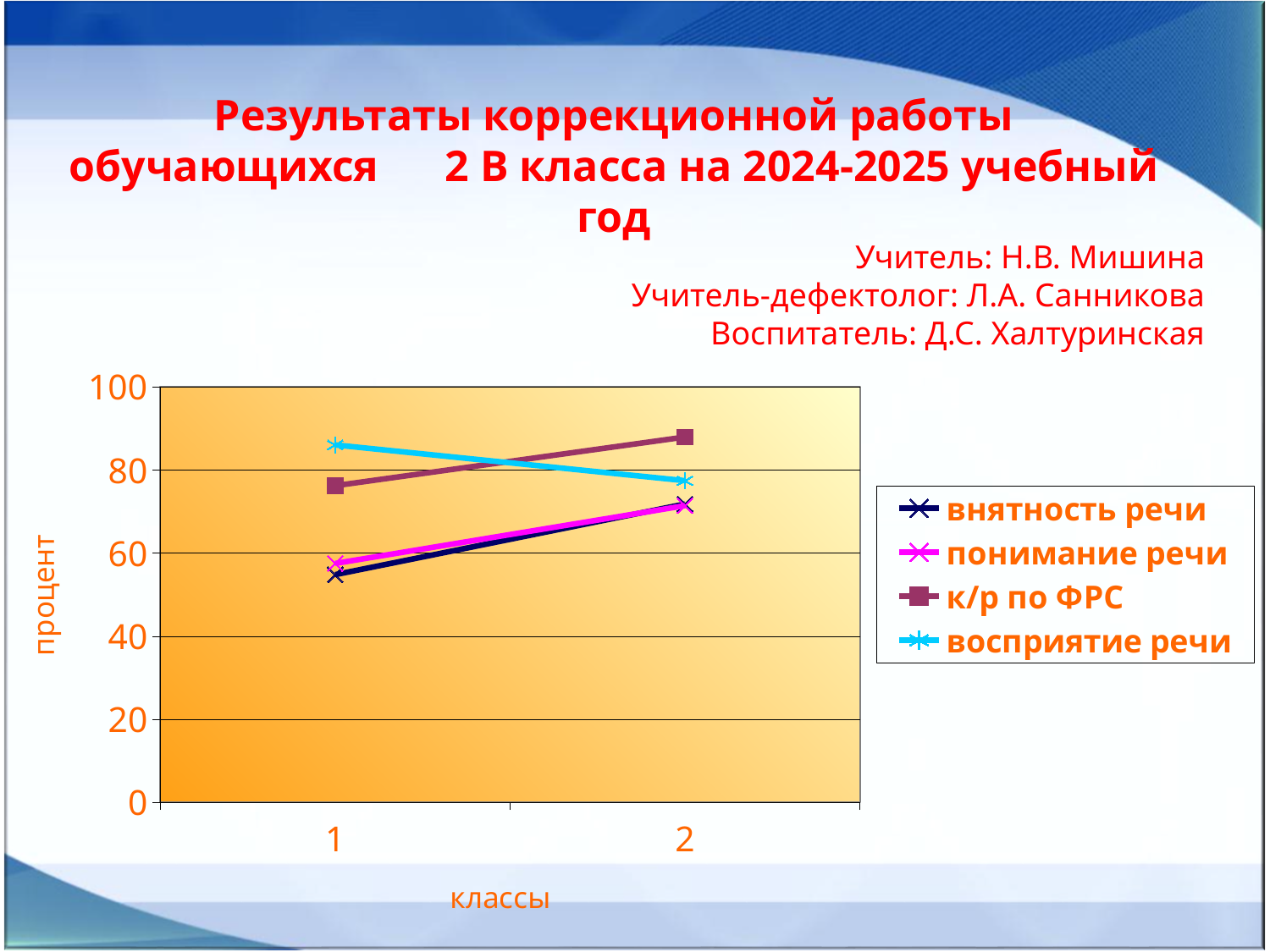
Which series has the highest value at class 2? к/р по ФРС At class 2, which is larger: the value for к/р по ФРС or the value for понимание речи? к/р по ФРС What kind of chart is shown on the slide? line chart What is the title of the vertical axis? процент How many series does the legend list? 4 Which series has the highest value at class 1? восприятие речи Does the value for восприятие речи rise or fall from class 1 to class 2? fall Does the value for внятность речи rise or fall from class 1 to class 2? rise Is the value for к/р по ФРС at class 2 greater or less than 80? greater Does the value for к/р по ФРС rise or fall from class 1 to class 2? rise Is the value for внятность речи at class 1 greater or less than 60? less How many categories are shown on the x axis (классы)? 2